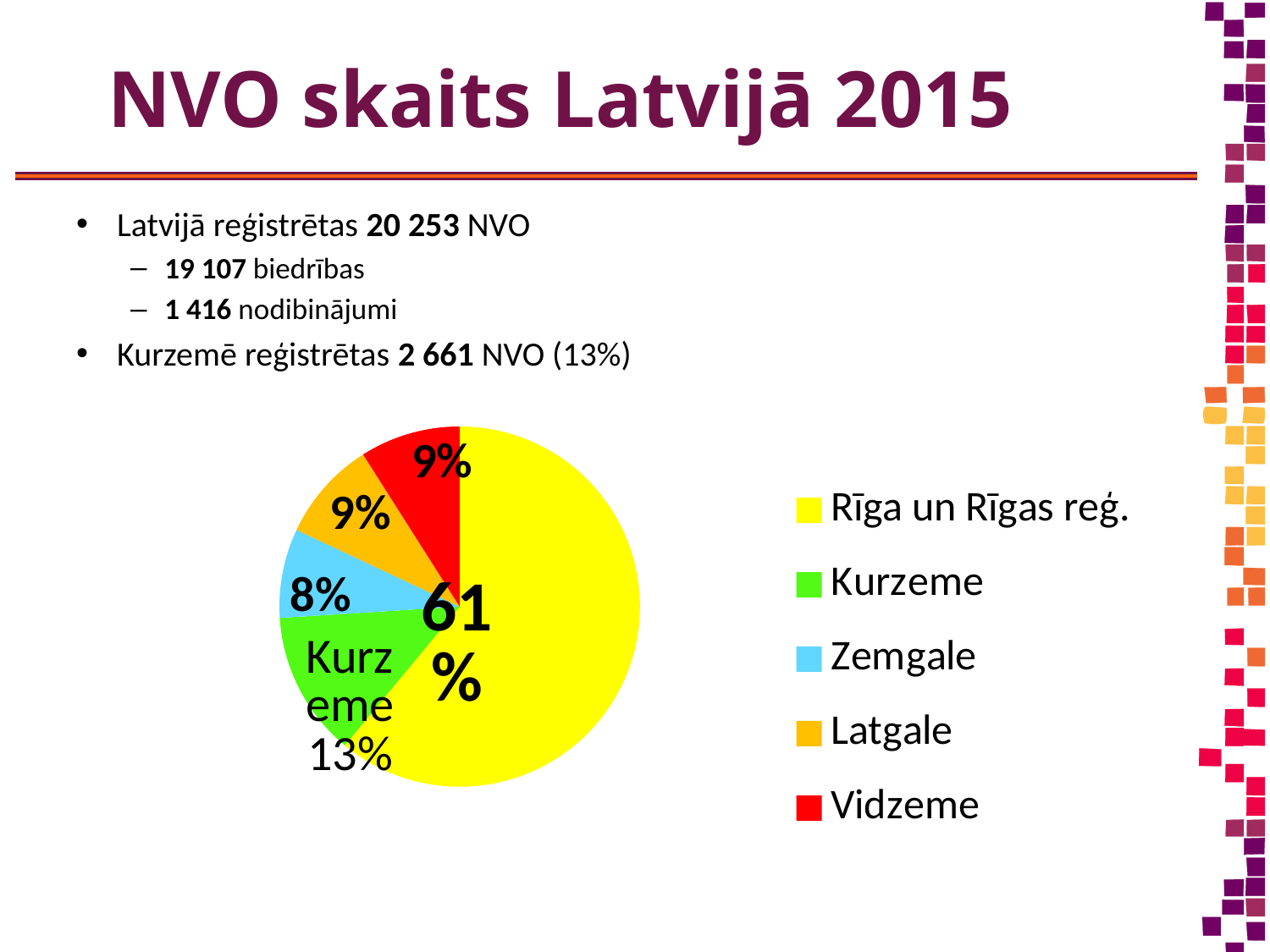
What share of the pie does Latgale hold? 9% What share of the pie does Kurzeme hold? 13% What is the difference in percentage points between the Rīga un Rīgas reģ. slice and the Kurzeme slice? 48 Which region has the smallest slice of the pie? Zemgale What share of the pie does Vidzeme hold? 9% What kind of chart is shown on the slide? pie chart Which slice is larger, Kurzeme or Zemgale? Kurzeme How many slices does the pie chart have? 5 Which region has the largest slice of the pie? Rīga un Rīgas reģ. What colour is the Vidzeme slice in the pie chart? red